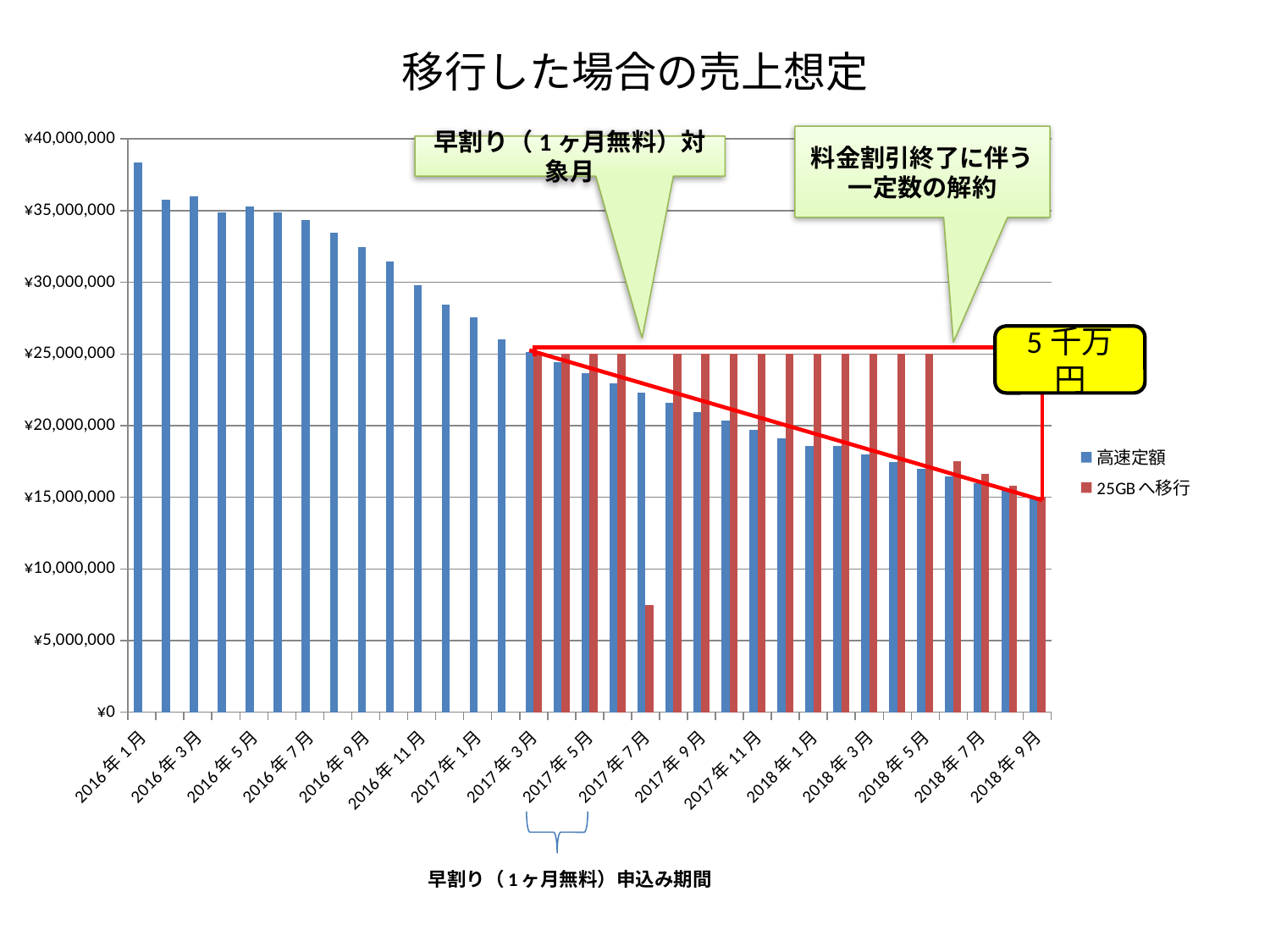
Which month has the highest value for the 高速定額 series? 2016年1月 Is the 高速定額 value for 2016年1月 greater or less than ¥35,000,000? greater What are the two series named in the legend? 高速定額 and 25GBへ移行 In 2017年7月, which series has the larger value, 高速定額 or 25GBへ移行? 高速定額 How many series does the legend list? 2 What is the title of the chart? 移行した場合の売上想定 Do the values of the 高速定額 series rise or fall from 2016年1月 to 2018年9月? fall In 2018年3月, which series has the larger value, 高速定額 or 25GBへ移行? 25GBへ移行 Which month has the lowest value for the 25GBへ移行 series? 2017年7月 Is the 25GBへ移行 value for 2017年7月 greater or less than ¥10,000,000? less What kind of chart is shown on the slide? bar chart Is the 高速定額 value for 2017年1月 greater or less than ¥25,000,000? greater